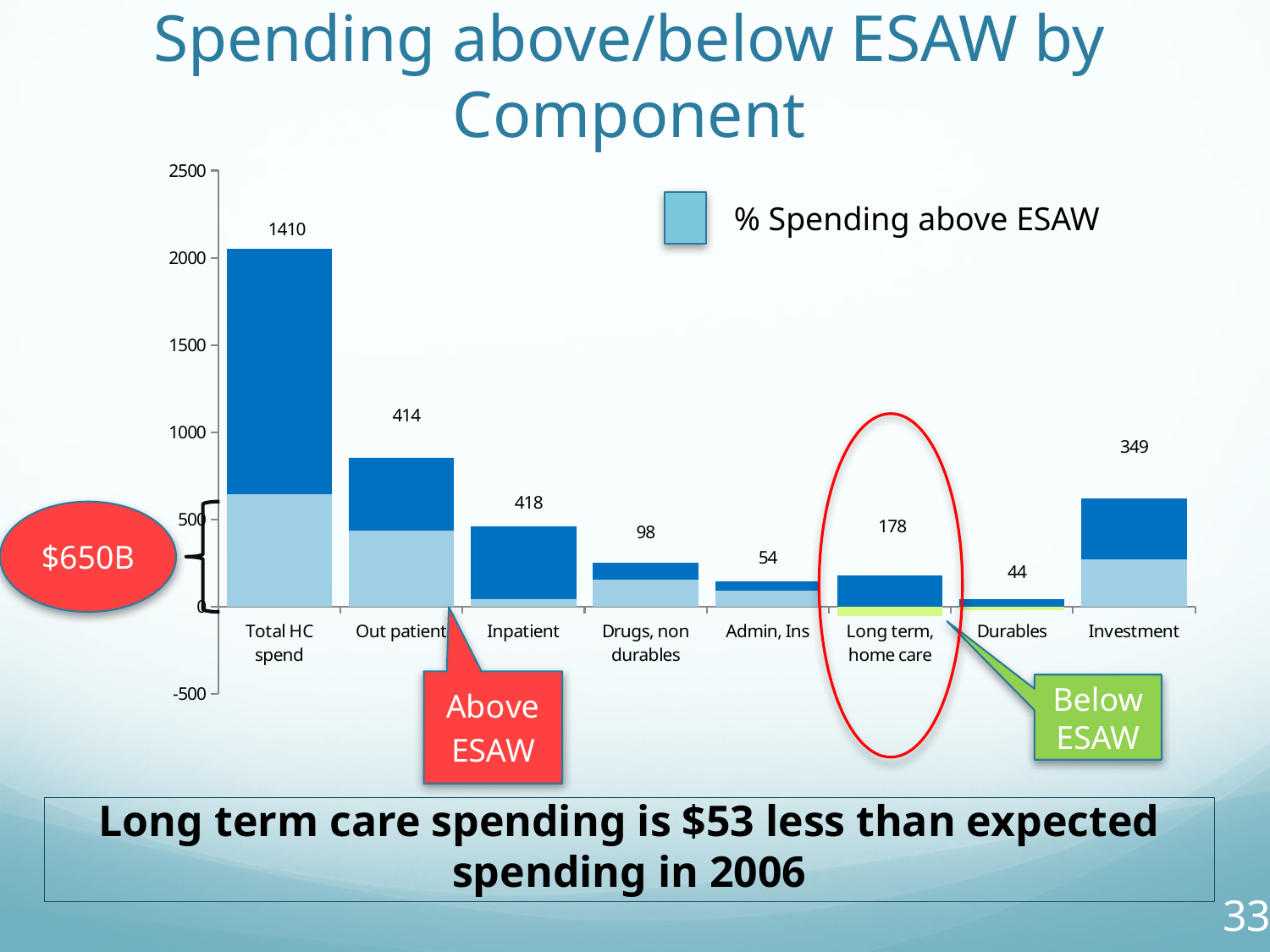
Which category has the highest labeled value? Total HC spend What is the difference between the labeled values for Drugs, non durables and Admin, Ins? 44 What kind of chart is shown on the slide? Bar chart What is the data label shown above the Investment bar? 349 Which category has the lowest labeled value? Durables What is the data label shown above the Total HC spend bar? 1410 Is the top of the Out patient bar greater or less than 1000? less What is the difference between the labeled values for Inpatient and Out patient? 4 What is the data label shown above the Durables bar? 44 Which has a larger labeled value, Investment or Long term, home care? Investment How many categories are shown on the x axis? 8 What is the data label shown above the Out patient bar? 414